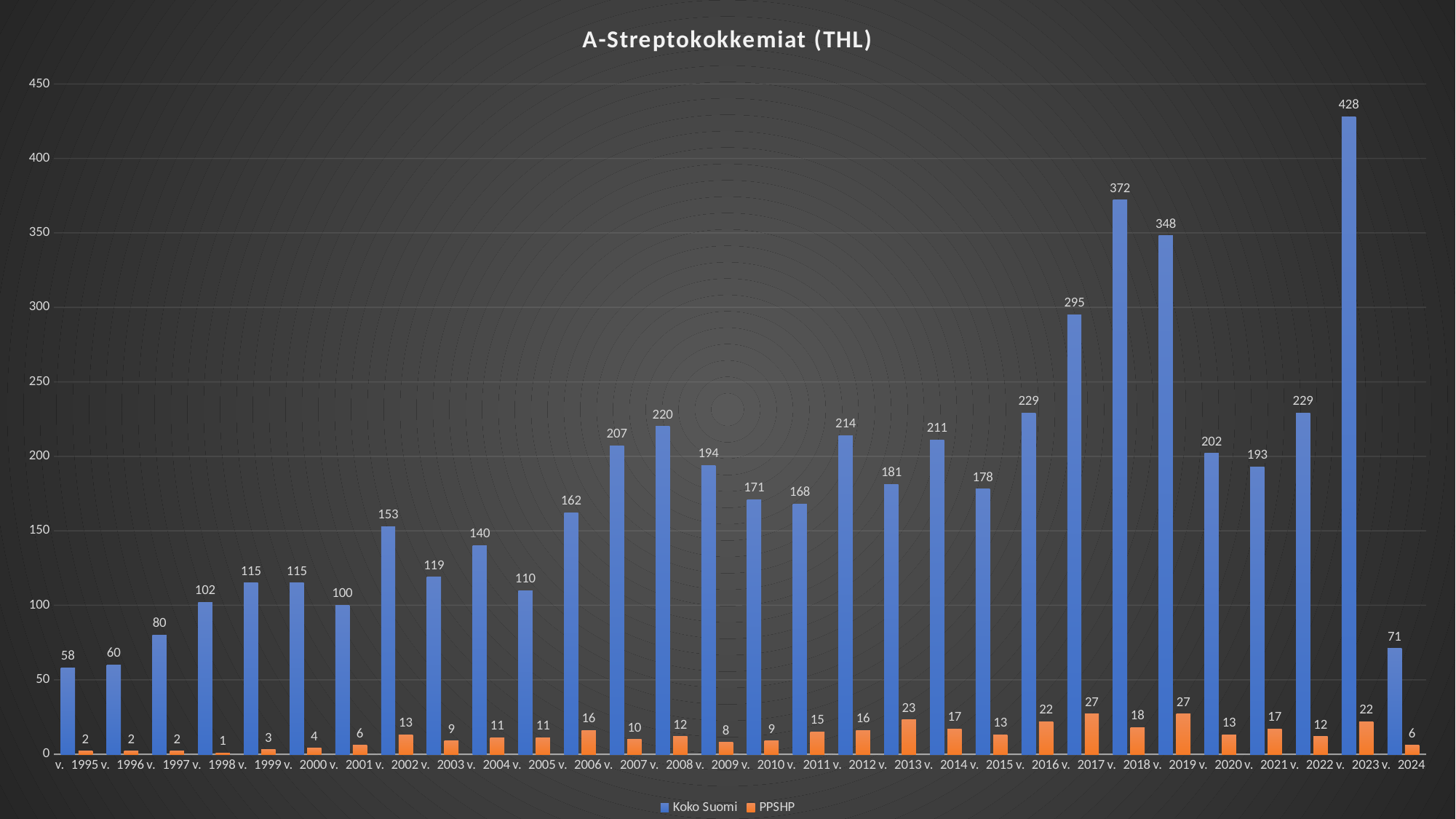
Which year has the highest Koko Suomi value? v. 2023 What is the difference between the Koko Suomi values for v. 2023 and v. 2018? 56 What type of chart is shown on the slide? Bar chart What is the title of the chart? A-Streptokokkemiat (THL) Is the Koko Suomi value for v. 2019 greater or less than 300? greater How many years (categories) are shown on the x axis? 30 How many series does the legend list? 2 What is the Koko Suomi value for v. 2018? 372 Which is larger, the Koko Suomi value for v. 2008 or for v. 2012? v. 2008 Which year has the lowest Koko Suomi value? v. 1995 Which year has the lowest PPSHP value? v. 1998 What is the PPSHP value for v. 2013? 23